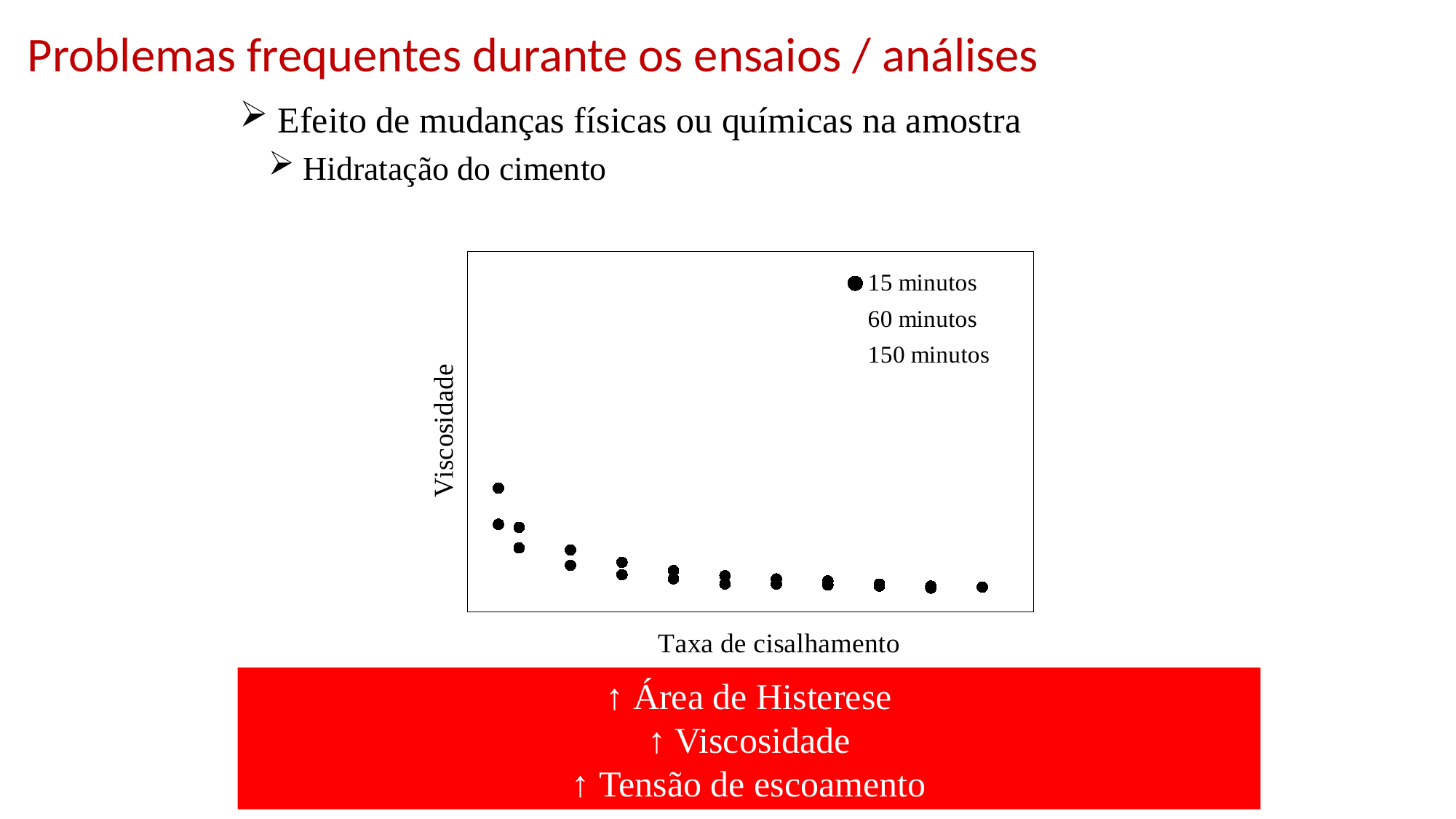
What are the three entries listed in the chart's legend? 15 minutos, 60 minutos, 150 minutos How many series does the chart's legend list? 3 Do the plotted viscosity values rise or fall as the shear rate (Taxa de cisalhamento) increases along the x axis? fall What kind of chart is shown on the slide? scatter chart What is the label of the vertical axis of the chart? Viscosidade